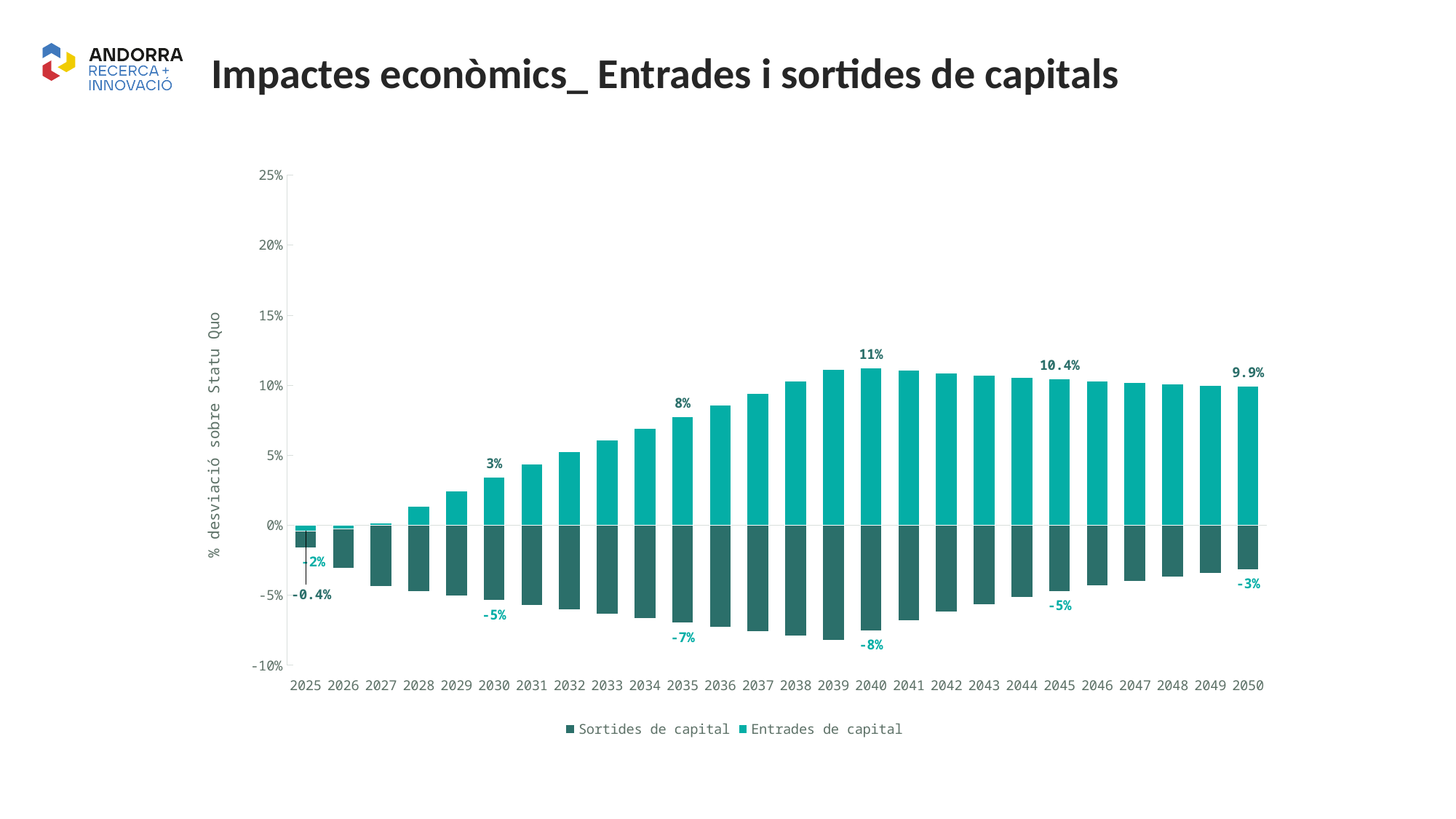
How many years are shown on the x axis? 26 What kind of chart is shown on the slide? Bar chart What is the value of Sortides de capital in 2035? -7% What is the value of Entrades de capital in 2050? 9.9% What is the title of the y axis? % desviació sobre Statu Quo What is the value of Entrades de capital in 2040? 11% How many series does the legend list? 2 Which is larger, Entrades de capital in 2035 or in 2045? 2045 What is the value of Sortides de capital in 2030? -5% Is the value for Entrades de capital in 2036 greater or less than 10%? less Do the Entrades de capital values rise or fall from 2025 to 2040? Rise By how many percentage points does Entrades de capital in 2045 exceed the value in 2050? 0.5 percentage points